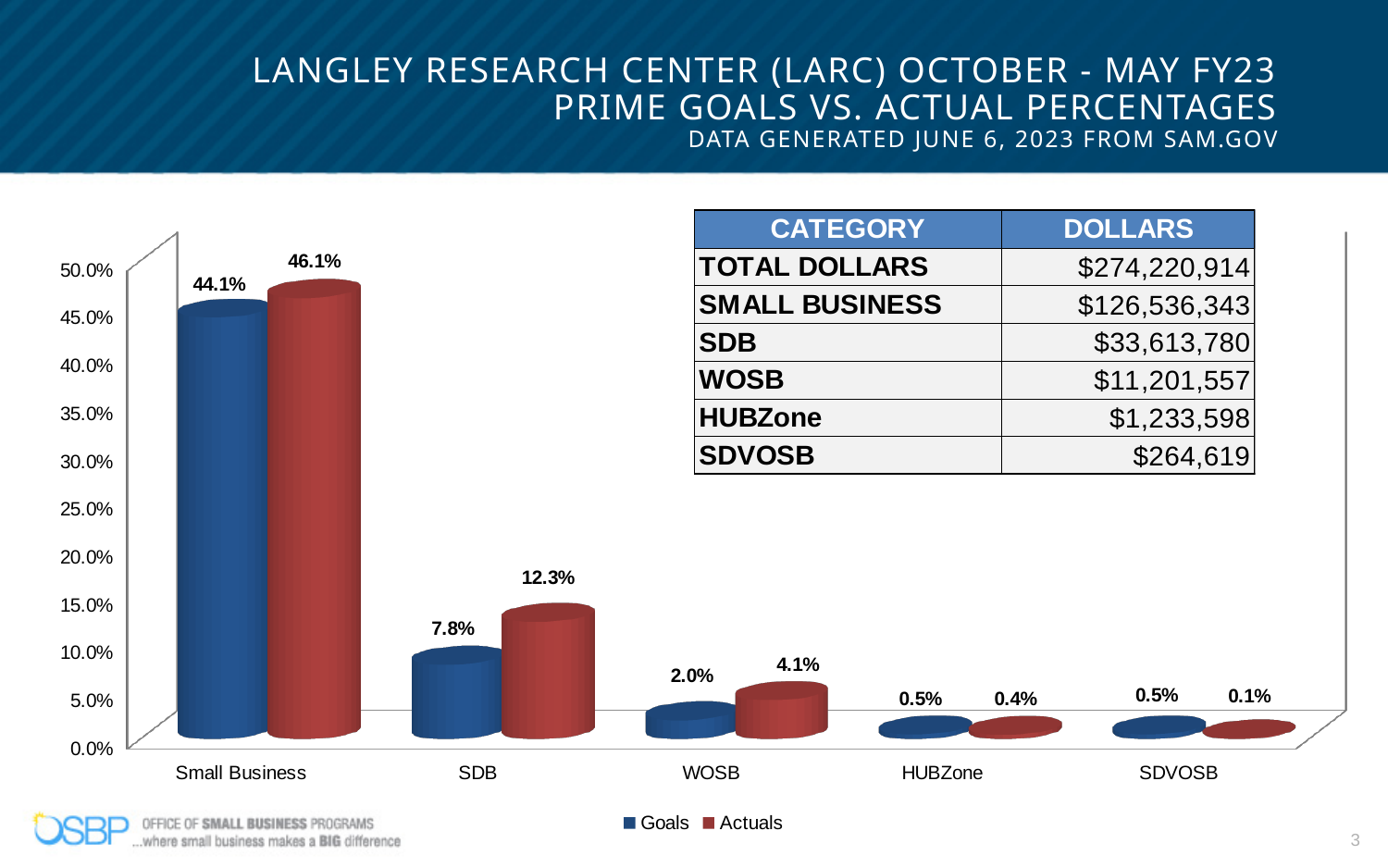
Which category has the lowest Actuals value? SDVOSB Which is larger for SDVOSB, the Goals value or the Actuals value? Goals What is the Actuals value for SDB? 12.3% What is the Actuals value for WOSB? 4.1% What is the Goals value for HUBZone? 0.5% What is the Goals value for Small Business? 44.1% Is the Actuals value for Small Business greater or less than 45.0%? greater Which category has the highest Actuals value? Small Business What is the difference between the Actuals and Goals values for SDB? 4.5% How many series does the chart legend list? 2 What kind of chart is shown on the slide? Bar chart How many categories are shown on the x axis of the chart? 5